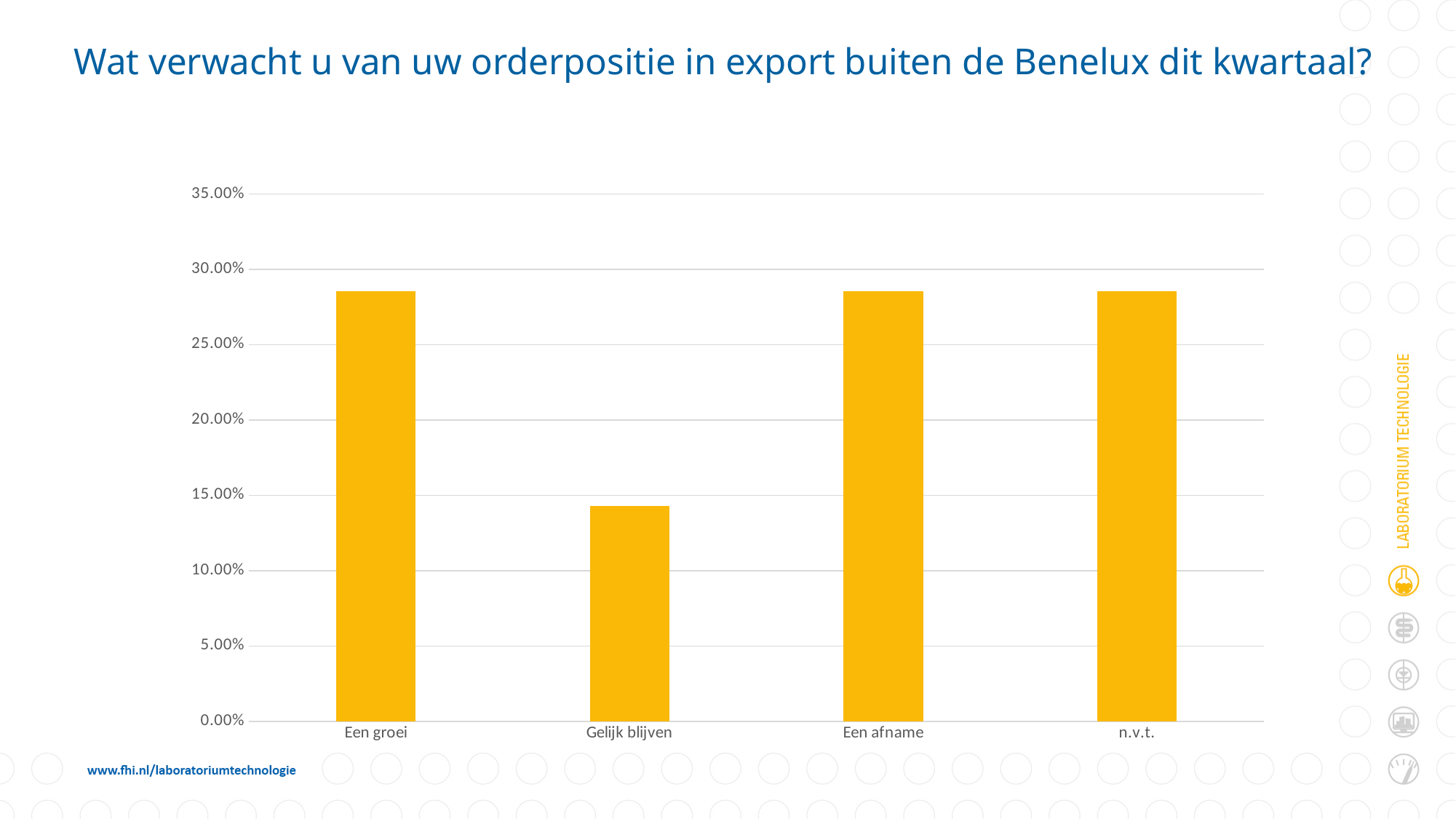
Is the value for Gelijk blijven greater or less than 15.00%? less Is the value for n.v.t. greater or less than 20.00%? greater Which category has the lowest value in the chart? Gelijk blijven Which is larger, the value for Een groei or the value for Gelijk blijven? Een groei Is the value for Een groei greater or less than 25.00%? greater What kind of chart is shown on the slide? bar chart Which is larger, the value for Gelijk blijven or the value for n.v.t.? n.v.t. What is the title of the chart on the slide? Wat verwacht u van uw orderpositie in export buiten de Benelux dit kwartaal? What colour are the bars in the chart? yellow How many categories are shown on the x axis of the chart? 4